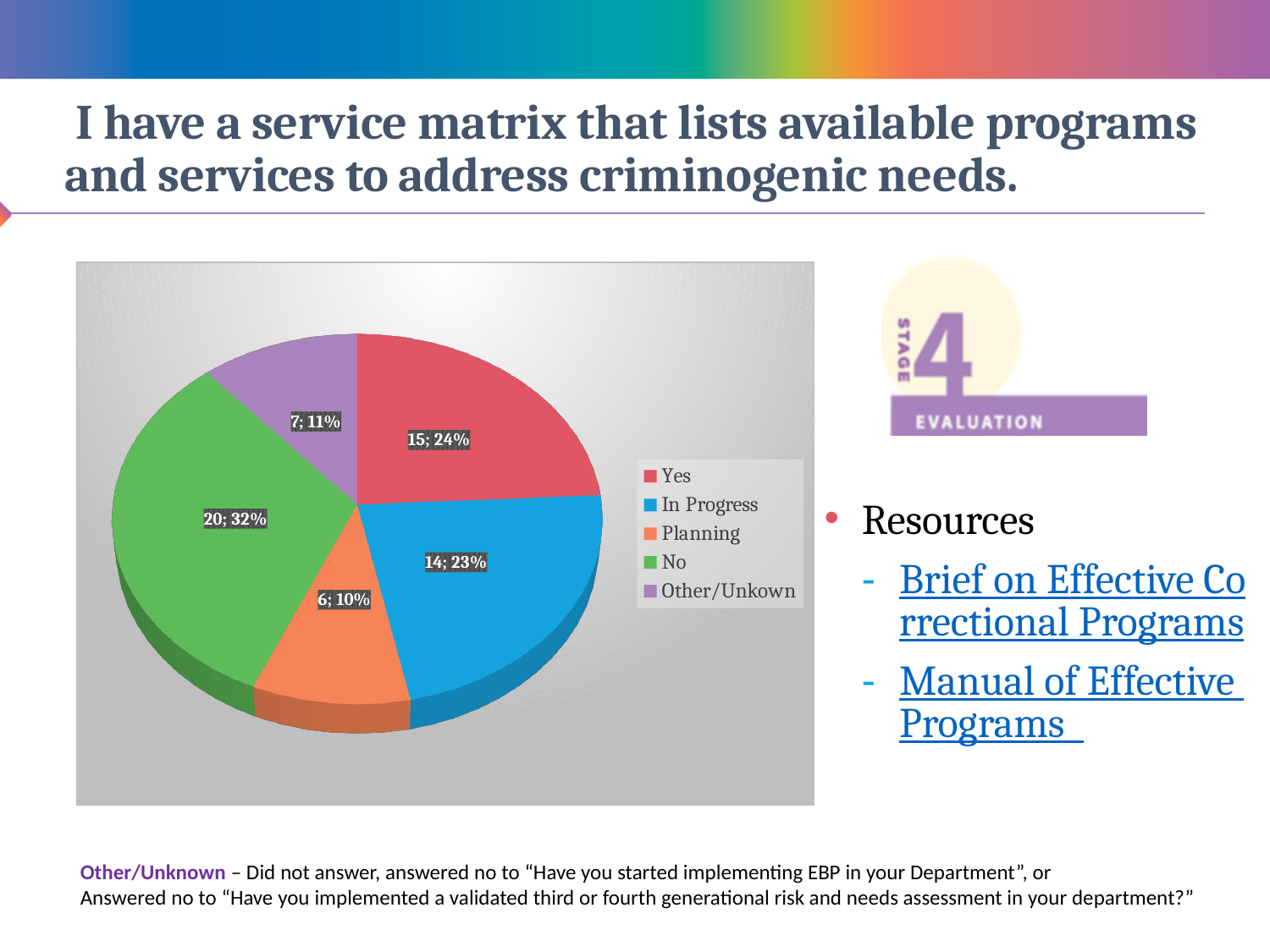
What type of chart is shown on the slide? Pie chart What is the count for the 'Planning' slice? 6 What percentage of the pie is the 'In Progress' slice? 23% Which is larger, the 'Other/Unkown' slice or the 'Planning' slice? Other/Unkown Which category has the smallest slice? Planning What is the difference in count between the 'No' slice and the 'Yes' slice? 5 What percentage of the pie is the 'No' slice? 32% What is the count for the 'Yes' slice? 15 Which category has the largest slice? No How many slices does the pie chart have? 5 What colour is the 'No' slice in the pie chart? Green How many entries does the legend list? 5